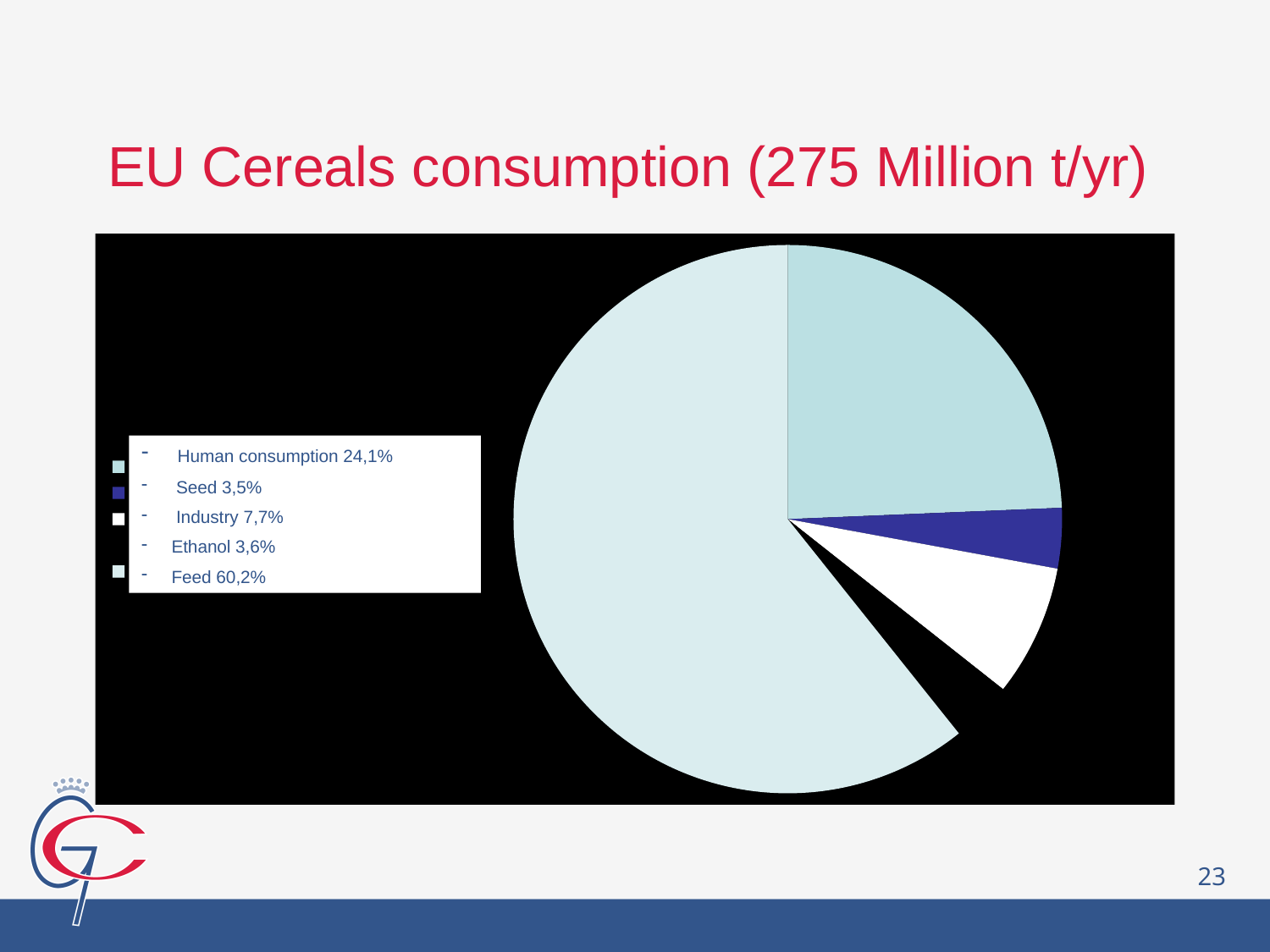
What percentage is shown for Industry? 7,7% Which category has the largest share of EU cereals consumption? Feed What share of EU cereals consumption goes to Human consumption? 24,1% How many categories does the legend list? 5 What is the title of the chart on the slide? EU Cereals consumption (275 Million t/yr) What percentage is shown for Seed? 3,5% Which is larger, the share for Industry or the share for Seed? Industry What is the difference in percentage points between Feed and Human consumption? 36,1 What kind of chart is shown on the slide? pie chart What percentage is shown for Ethanol? 3,6% What share of EU cereals consumption goes to Feed? 60,2% Which category has the smallest share according to the legend? Seed